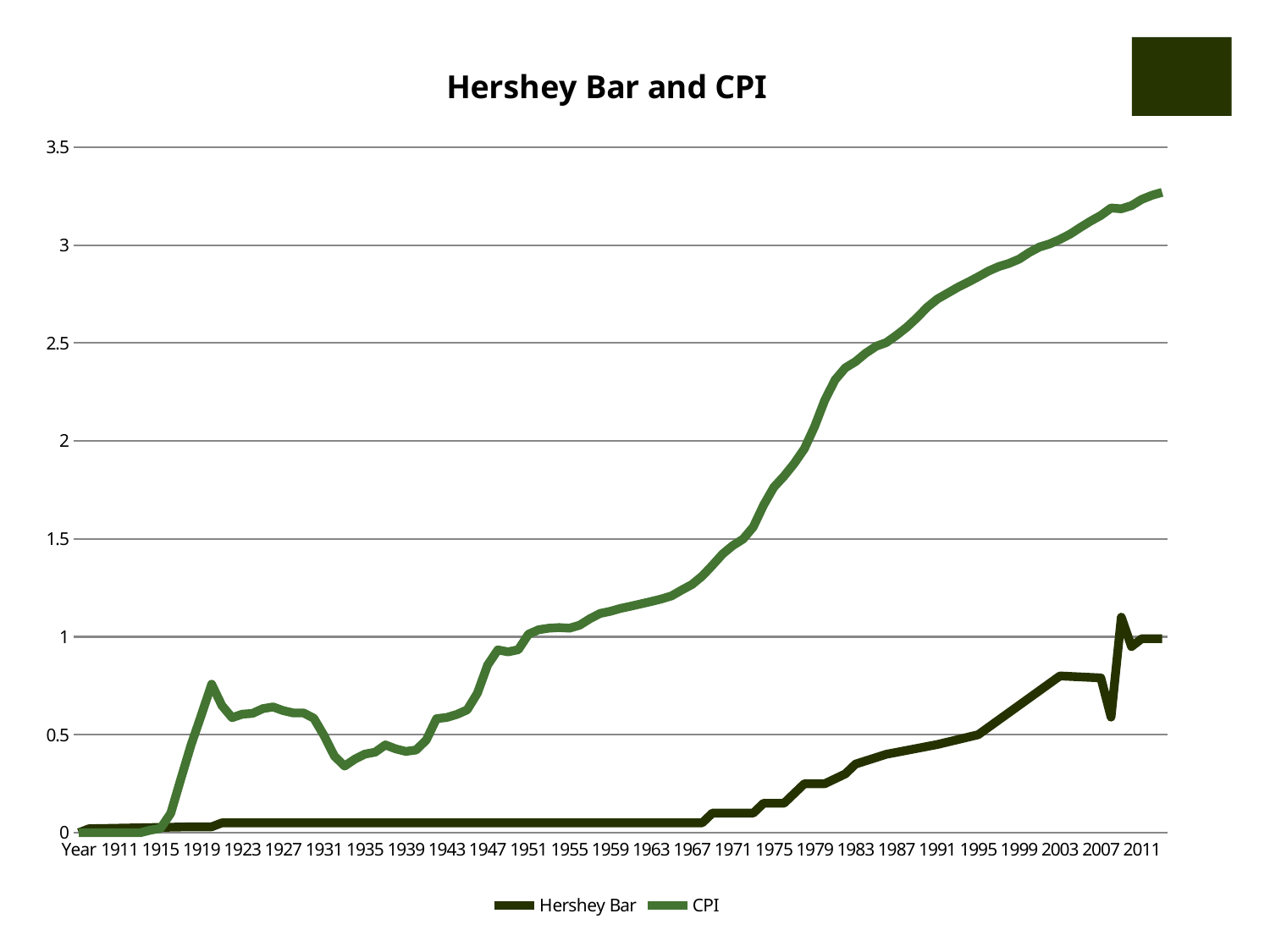
Is the CPI value for 1935 greater or less than 0.5? less What is the title of the chart? Hershey Bar and CPI How many series does the legend list? 2 In 2011, which series has the larger value, Hershey Bar or CPI? CPI Is the CPI value for 1963 greater or less than 1? greater Is the CPI value for 2011 greater or less than 3? greater Which two series are listed in the legend? Hershey Bar and CPI What kind of chart is shown on the slide? line chart Does the CPI line generally rise or fall from 1911 to 2011? rise